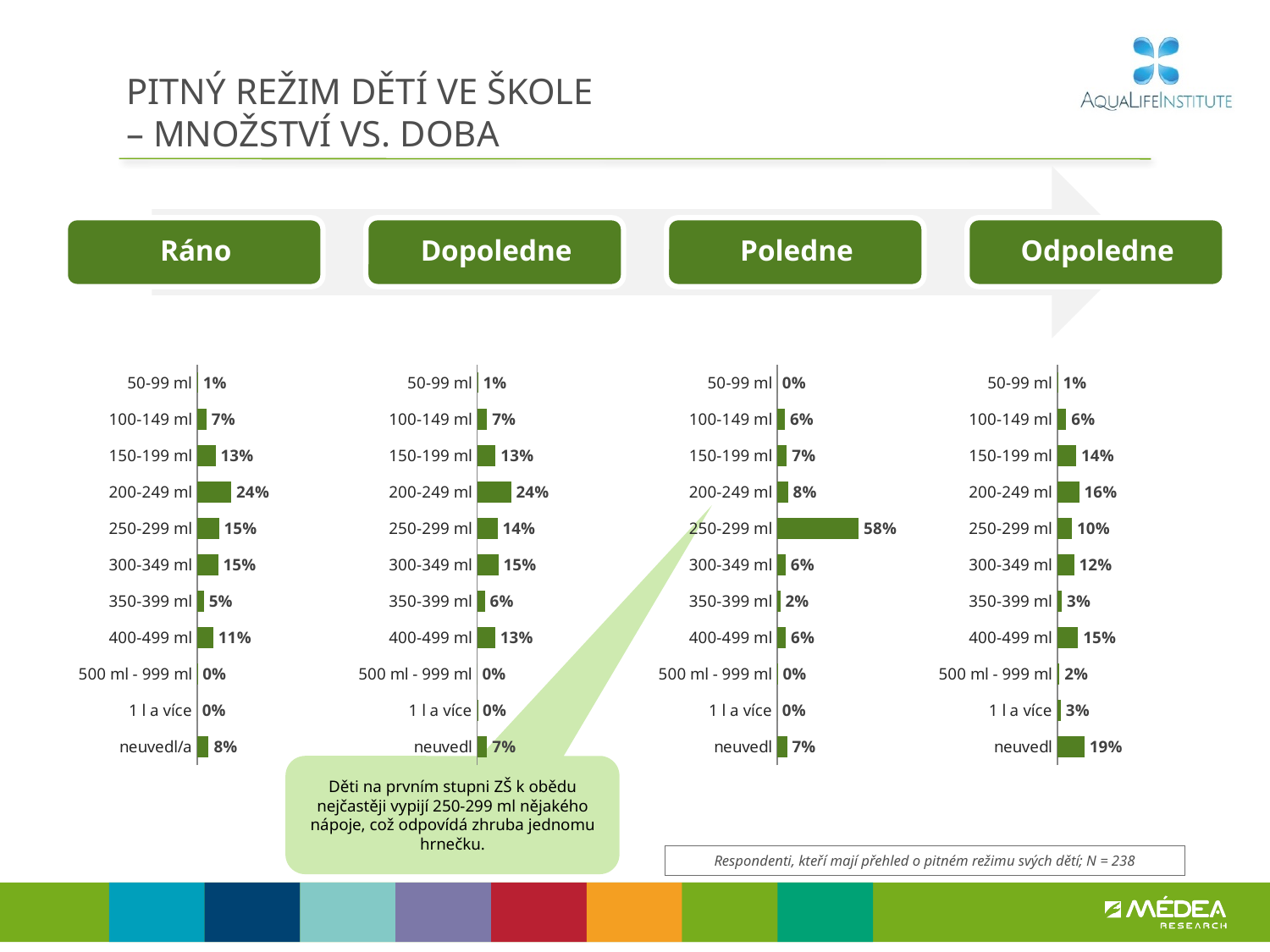
What kind of chart is the Ráno chart? bar chart In the Odpoledne chart, what is the value for neuvedl? 19% In the Odpoledne chart, which is larger: the value for 200-249 ml or the value for 250-299 ml? 200-249 ml In the Ráno chart, what is the difference between the values for 200-249 ml and 250-299 ml? 9% In the Poledne chart, what is the value for 250-299 ml? 58% How many charts are shown on the slide? 4 How many categories does the Dopoledne chart show? 11 In the Poledne chart, which category has the highest value? 250-299 ml In the Poledne chart, what is the difference between the values for 250-299 ml and 200-249 ml? 50% In the Ráno chart, what is the value for 200-249 ml? 24% In the Odpoledne chart, which category has the highest value? neuvedl In the Dopoledne chart, what is the value for 400-499 ml? 13%